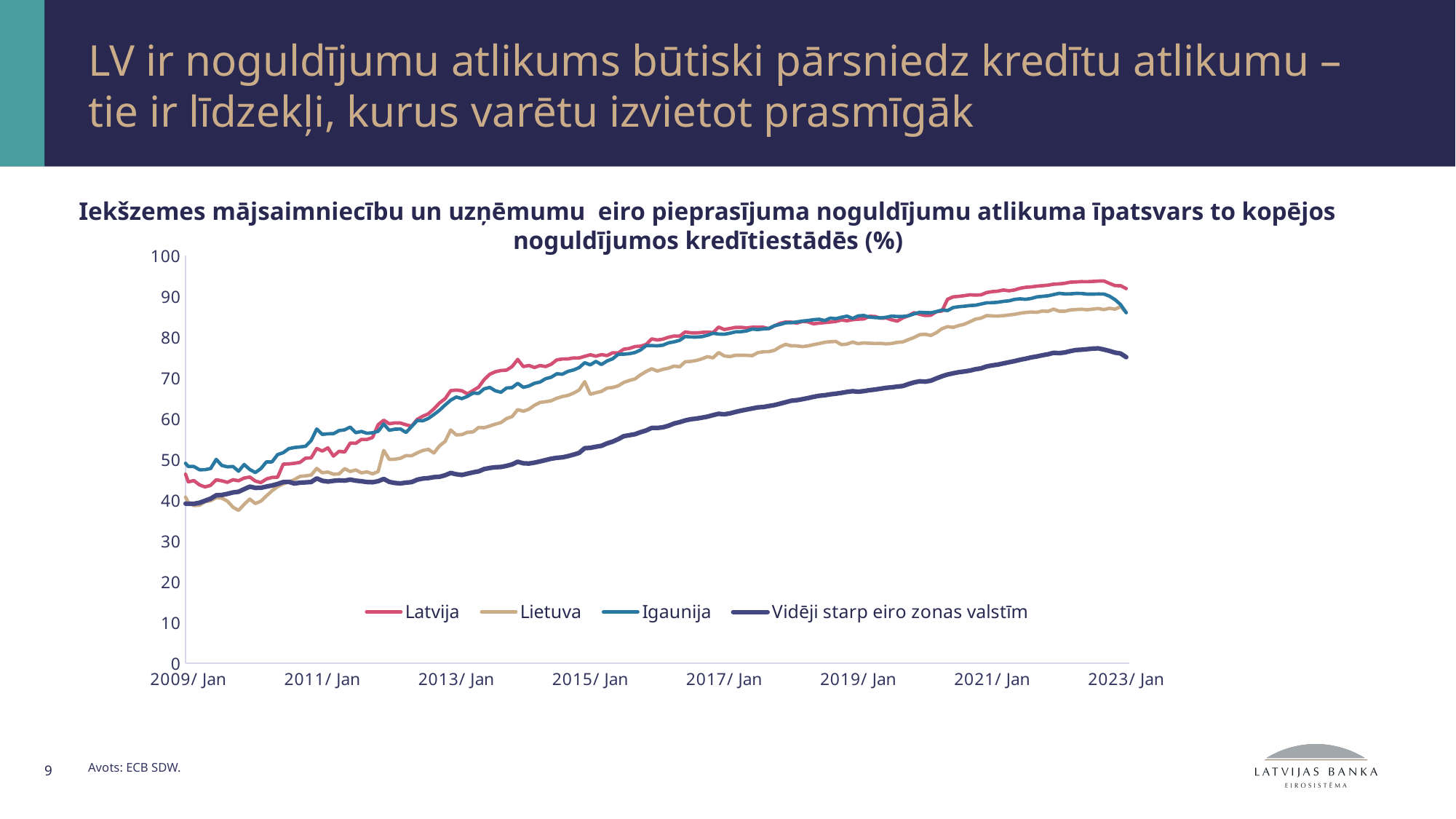
Does the Latvija line generally rise or fall from 2009/Jan to 2023/Jan? rise Does the Vidēji starp eiro zonas valstīm line generally rise or fall over the period shown? rise Which series does the legend list last? Vidēji starp eiro zonas valstīm Which series has the highest value at 2023/Jan? Latvija Is the value for Latvija at 2023/Jan greater or less than 90? greater Is the value for Vidēji starp eiro zonas valstīm at 2023/Jan greater or less than 80? less At 2023/Jan, which is larger: the value for Latvija or the value for Vidēji starp eiro zonas valstīm? Latvija What is the source cited for the chart? ECB SDW What kind of chart is shown on the slide? line chart Which series has the lowest value at 2023/Jan? Vidēji starp eiro zonas valstīm Is the value for Lietuva at 2017/Jan greater or less than 70? greater How many series does the chart legend list? 4